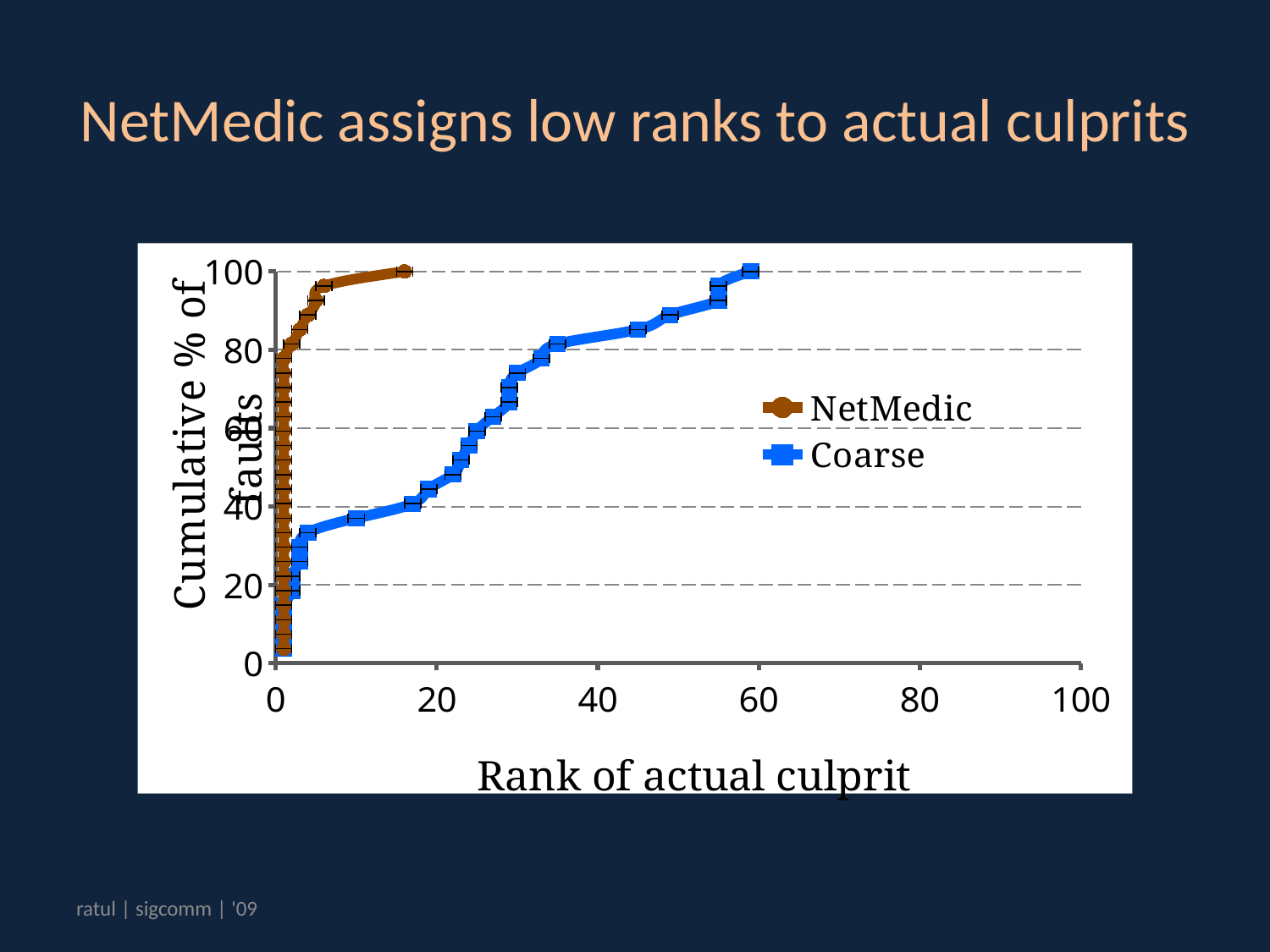
How many series does the legend list? 2 Is the rank at which Coarse reaches 100% of faults greater or less than 40? greater At a rank of 10, which series has the higher cumulative % of faults, NetMedic or Coarse? NetMedic Which series reaches 100% cumulative faults at a lower rank, NetMedic or Coarse? NetMedic What are the two series named in the legend? NetMedic and Coarse What is the highest value shown on the x axis? 100 What is the label of the x axis? Rank of actual culprit Do the values of the Coarse series rise or fall as the rank of actual culprit increases? rise Is the cumulative % of faults for Coarse at rank 30 greater or less than 60? greater Is the cumulative % of faults for Coarse at rank 10 greater or less than 40? less What kind of chart is shown on the slide? line chart